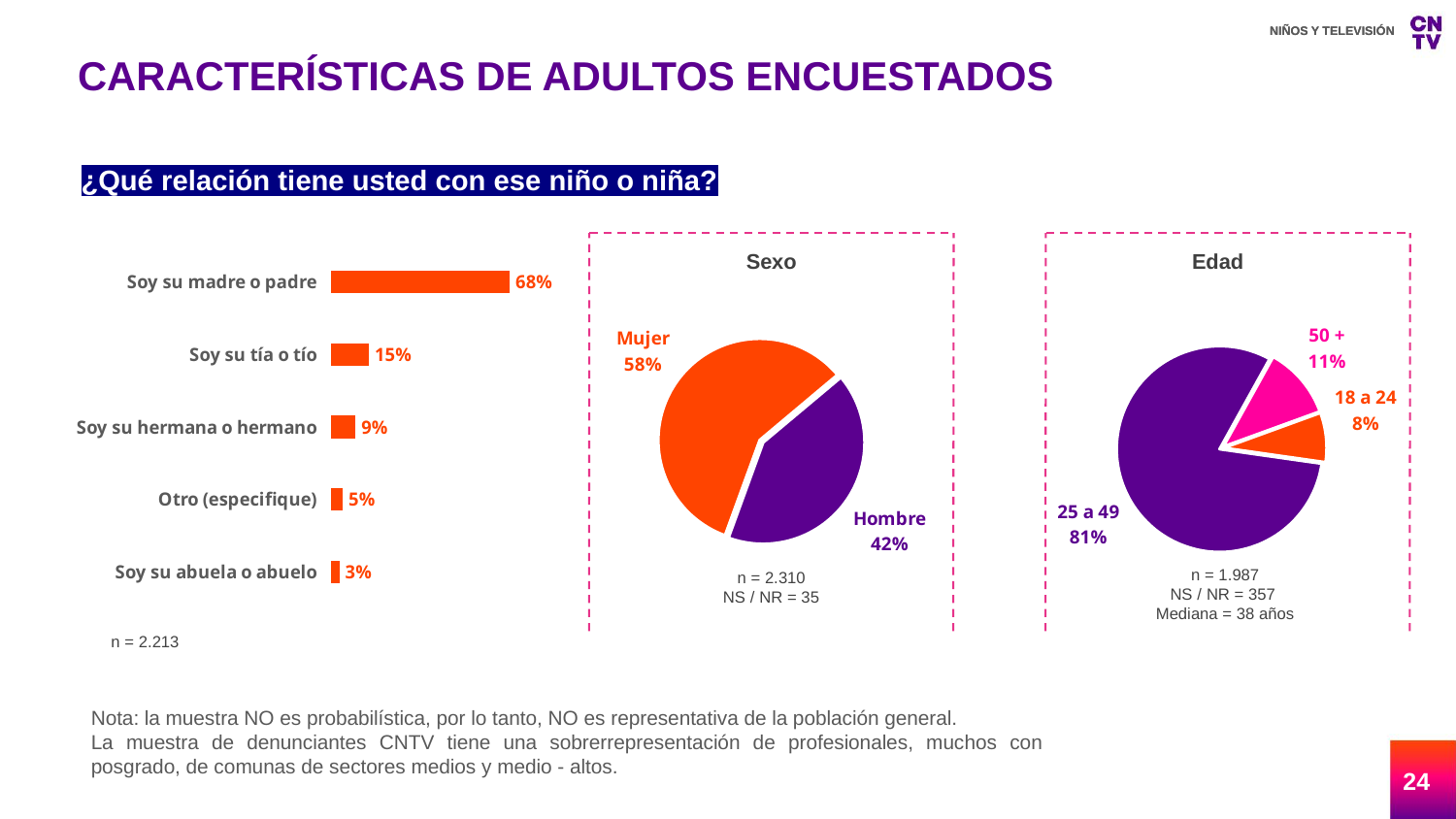
What kind of chart is the 'Edad' chart? Pie chart In the bar chart '¿Qué relación tiene usted con ese niño o niña?', which category has the highest value? Soy su madre o padre In the bar chart '¿Qué relación tiene usted con ese niño o niña?', which category has the lowest value? Soy su abuela o abuelo In the bar chart '¿Qué relación tiene usted con ese niño o niña?', what is the value for 'Soy su hermana o hermano'? 9% In the 'Sexo' pie chart, which is larger, 'Mujer' or 'Hombre'? Mujer What kind of chart is the chart on the left titled '¿Qué relación tiene usted con ese niño o niña?'? Bar chart How many categories are shown in the bar chart '¿Qué relación tiene usted con ese niño o niña?'? 5 In the 'Edad' pie chart, which age group has the smallest share? 18 a 24 In the bar chart '¿Qué relación tiene usted con ese niño o niña?', what is the difference between 'Soy su tía o tío' and 'Otro (especifique)'? 10% In the 'Edad' pie chart, what share is '25 a 49'? 81% In the bar chart '¿Qué relación tiene usted con ese niño o niña?', what is the value for 'Soy su madre o padre'? 68% In the 'Sexo' pie chart, what share is 'Mujer'? 58%